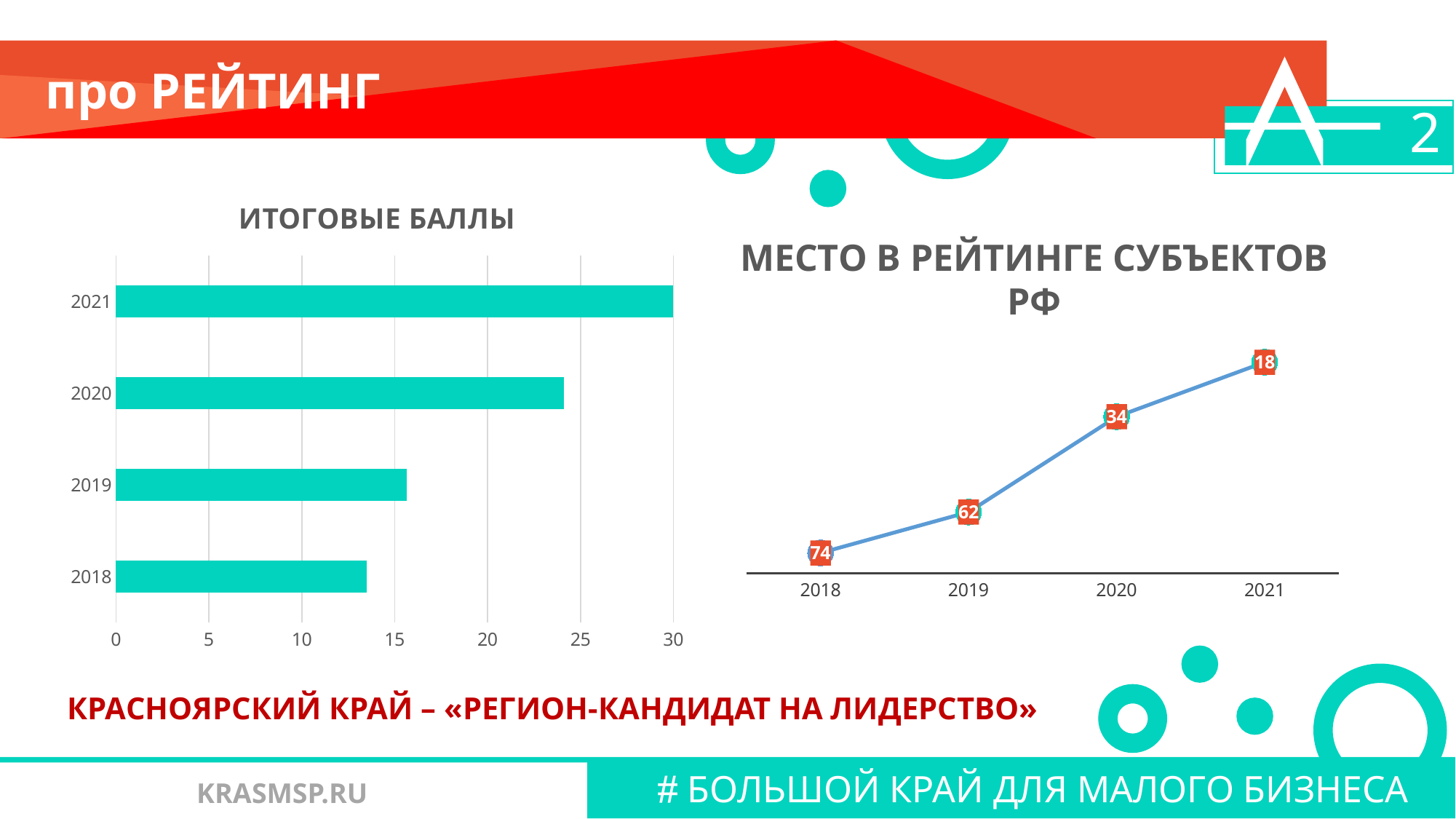
In the chart titled «ИТОГОВЫЕ БАЛЛЫ», which year has the longest bar? 2021 In the chart titled «МЕСТО В РЕЙТИНГЕ СУБЪЕКТОВ РФ», do the labelled values increase or decrease from 2018 to 2021? decrease In the chart titled «МЕСТО В РЕЙТИНГЕ СУБЪЕКТОВ РФ», what is the value for 2020? 34 In the chart titled «МЕСТО В РЕЙТИНГЕ СУБЪЕКТОВ РФ», which year has the lowest value? 2021 In the chart titled «ИТОГОВЫЕ БАЛЛЫ», is the value for 2018 greater or less than 15? less In the chart titled «МЕСТО В РЕЙТИНГЕ СУБЪЕКТОВ РФ», how many data points are plotted? 4 In the chart titled «МЕСТО В РЕЙТИНГЕ СУБЪЕКТОВ РФ», what is the difference between the values for 2019 and 2020? 28 In the chart titled «МЕСТО В РЕЙТИНГЕ СУБЪЕКТОВ РФ», what is the value for 2018? 74 In the chart titled «МЕСТО В РЕЙТИНГЕ СУБЪЕКТОВ РФ», which year has the highest value? 2018 In the chart titled «МЕСТО В РЕЙТИНГЕ СУБЪЕКТОВ РФ», what is the value for 2021? 18 What kind of chart is the one titled «ИТОГОВЫЕ БАЛЛЫ»? bar chart In the chart titled «ИТОГОВЫЕ БАЛЛЫ», is the value for 2020 greater or less than 20? greater